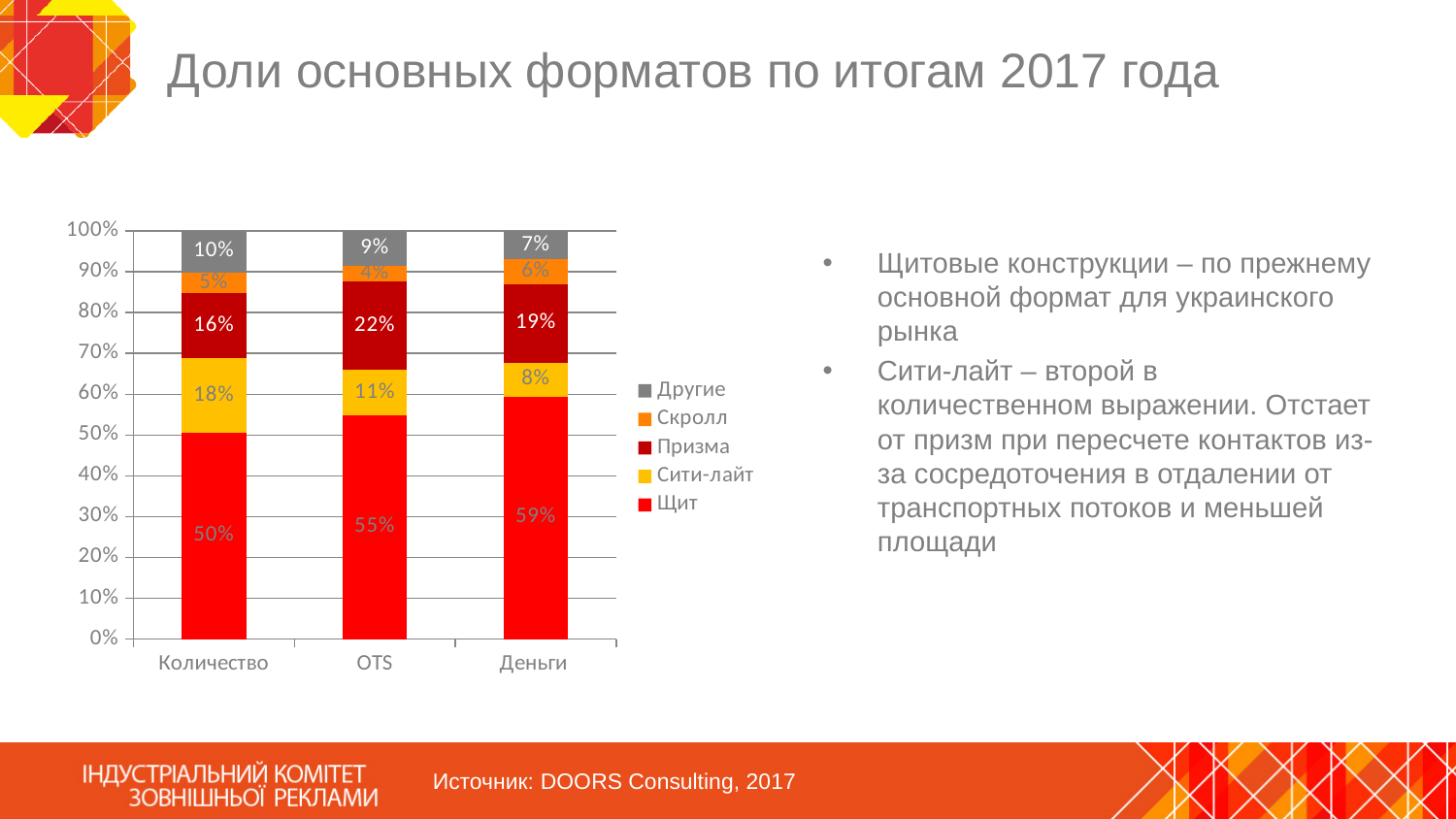
Which is larger: Призма for Количество or Призма for OTS? Призма for OTS How many series does the legend list? 5 What is the value of Другие for Деньги? 7% What is the value of Призма for OTS? 22% What is the value of Щит for Количество? 50% Does the value of Щит rise or fall from Количество to Деньги? Rise Which category has the highest value for Щит? Деньги What is the difference between the Щит values for Деньги and Количество? 9% What kind of chart is shown on the slide? Stacked bar chart How many categories are shown on the x axis? 3 What is the value of Сити-лайт for Деньги? 8% Which category has the lowest value for Сити-лайт? Деньги